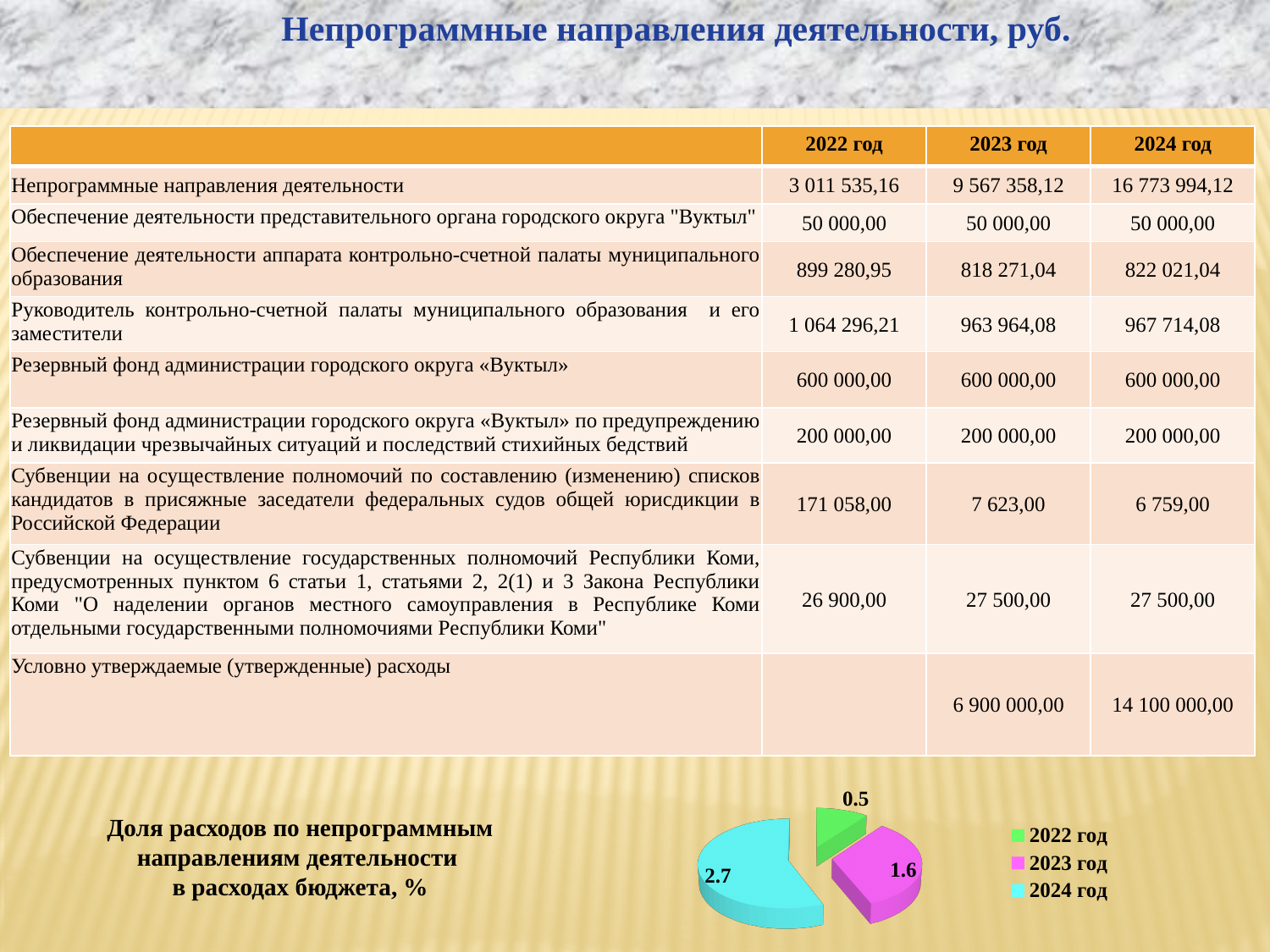
In the pie chart, what is the value for 2024 год? 2.7 In the pie chart, what is the value for 2022 год? 0.5 What colour is the slice for 2024 год in the pie chart? cyan (light blue) Which year has the largest slice in the pie chart? 2024 год In the pie chart, which is larger: the value for 2023 год or the value for 2022 год? 2023 год In the pie chart, what is the difference between the values for 2024 год and 2023 год? 1.1 How many entries does the pie chart legend list? 3 Which year has the smallest slice in the pie chart? 2022 год What type of chart is shown at the bottom of the slide? pie chart In the pie chart, what is the difference between the values for 2023 год and 2022 год? 1.1 In the pie chart, what is the value for 2023 год? 1.6 How many slices does the pie chart have? 3